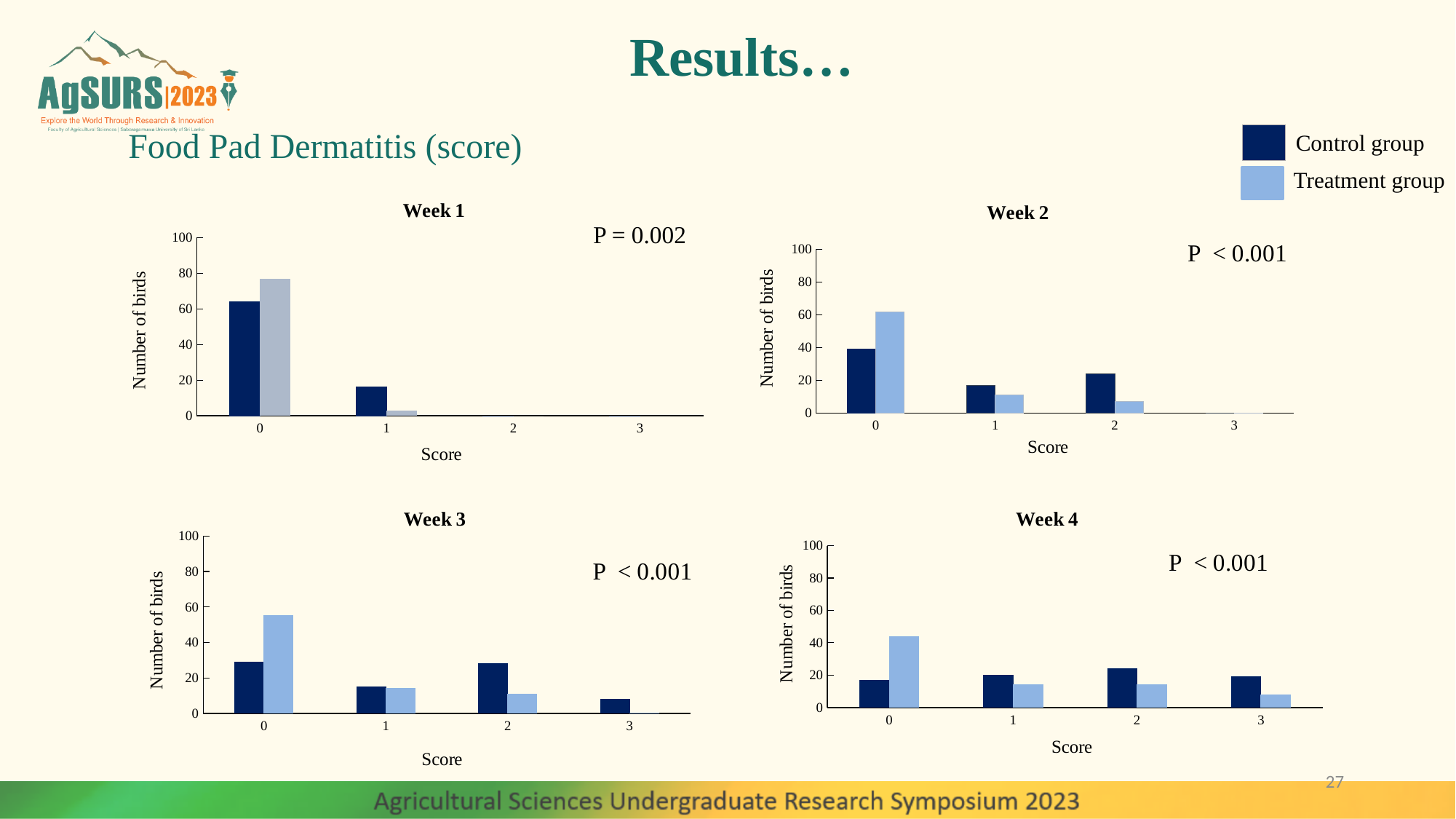
How many series does the legend list for the charts? 2 In the Week 1 chart, is the value for the Treatment group at score 0 greater or less than 60? greater In the Week 2 chart, how many score categories are shown on the x axis? 4 In the Week 1 chart, at score 0, which group has the larger value, Control group or Treatment group? Treatment group In the Week 3 chart, which score has the highest Treatment group value? 0 In the Week 3 chart, at score 2, which group has the larger value, Control group or Treatment group? Control group In the Week 2 chart, which score has the highest Control group value? 0 What kind of chart is the Week 1 chart? bar chart In the Week 2 chart, is the value for the Treatment group at score 0 greater or less than 40? greater What P value is shown on the Week 1 chart? P = 0.002 In the Week 3 chart, which score has the lowest Control group value? 3 In the Week 4 chart, is the value for the Treatment group at score 3 greater or less than 20? less